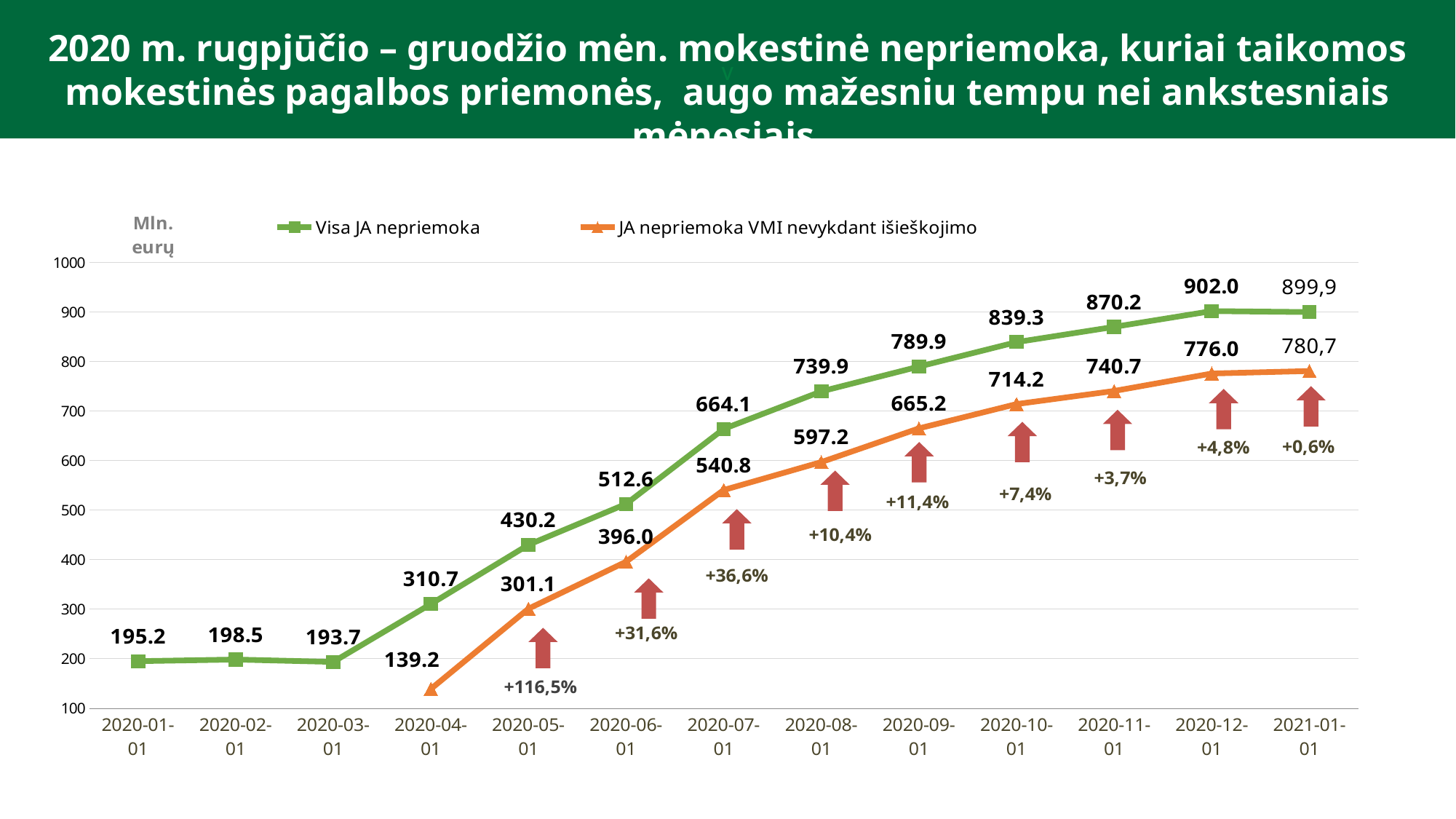
What is the value of JA nepriemoka VMI nevykdant išieškojimo on 2020-10-01? 714.2 What is the difference between Visa JA nepriemoka and JA nepriemoka VMI nevykdant išieškojimo on 2020-12-01? 126.0 What is the value of Visa JA nepriemoka on 2020-07-01? 664.1 What kind of chart is shown on the slide? line chart Does Visa JA nepriemoka rise or fall from 2020-03-01 to 2020-12-01? rise How many dates are shown on the x axis? 13 On which date is JA nepriemoka VMI nevykdant išieškojimo at its lowest value? 2020-04-01 How many series does the legend list? 2 Is the value of Visa JA nepriemoka on 2020-06-01 greater or less than 500? greater What percentage change is labelled next to the arrow at 2020-05-01? +116,5% On which date does Visa JA nepriemoka reach its highest value? 2020-12-01 Which date has the larger Visa JA nepriemoka value, 2020-01-01 or 2020-03-01? 2020-01-01